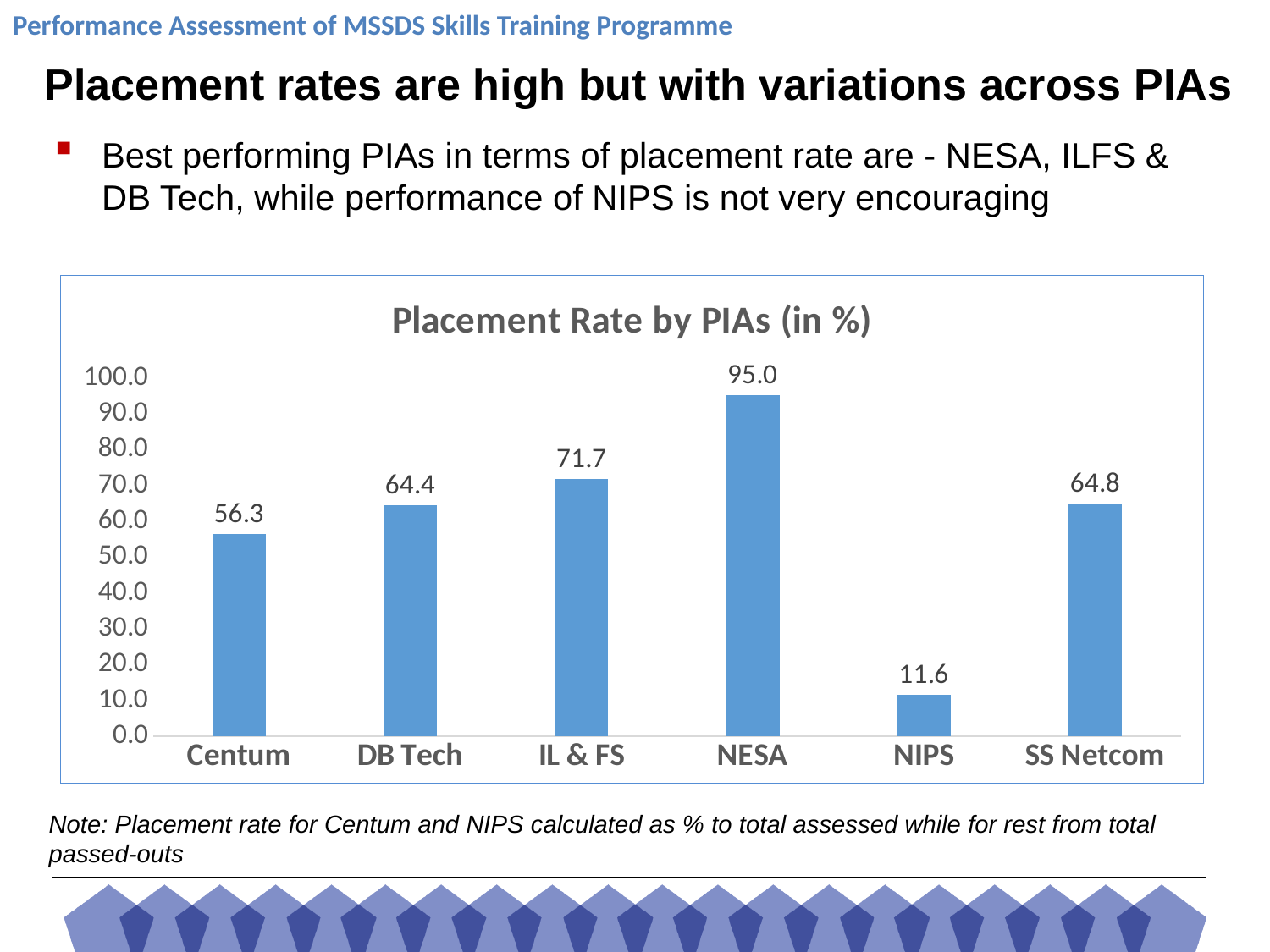
What is the difference between the placement rates of NESA and NIPS? 83.4 What is the title of the chart? Placement Rate by PIAs (in %) What is the placement rate for NIPS? 11.6 What type of chart is used to show placement rate by PIAs? Bar chart What is the difference between the placement rates of IL & FS and DB Tech? 7.3 Is the placement rate for IL & FS greater or less than 70.0? greater Which PIA has the highest placement rate? NESA What is the placement rate for Centum? 56.3 Which has a higher placement rate, SS Netcom or Centum? SS Netcom What is the placement rate for NESA? 95.0 Which PIA has the lowest placement rate? NIPS How many PIAs are shown in the chart? 6